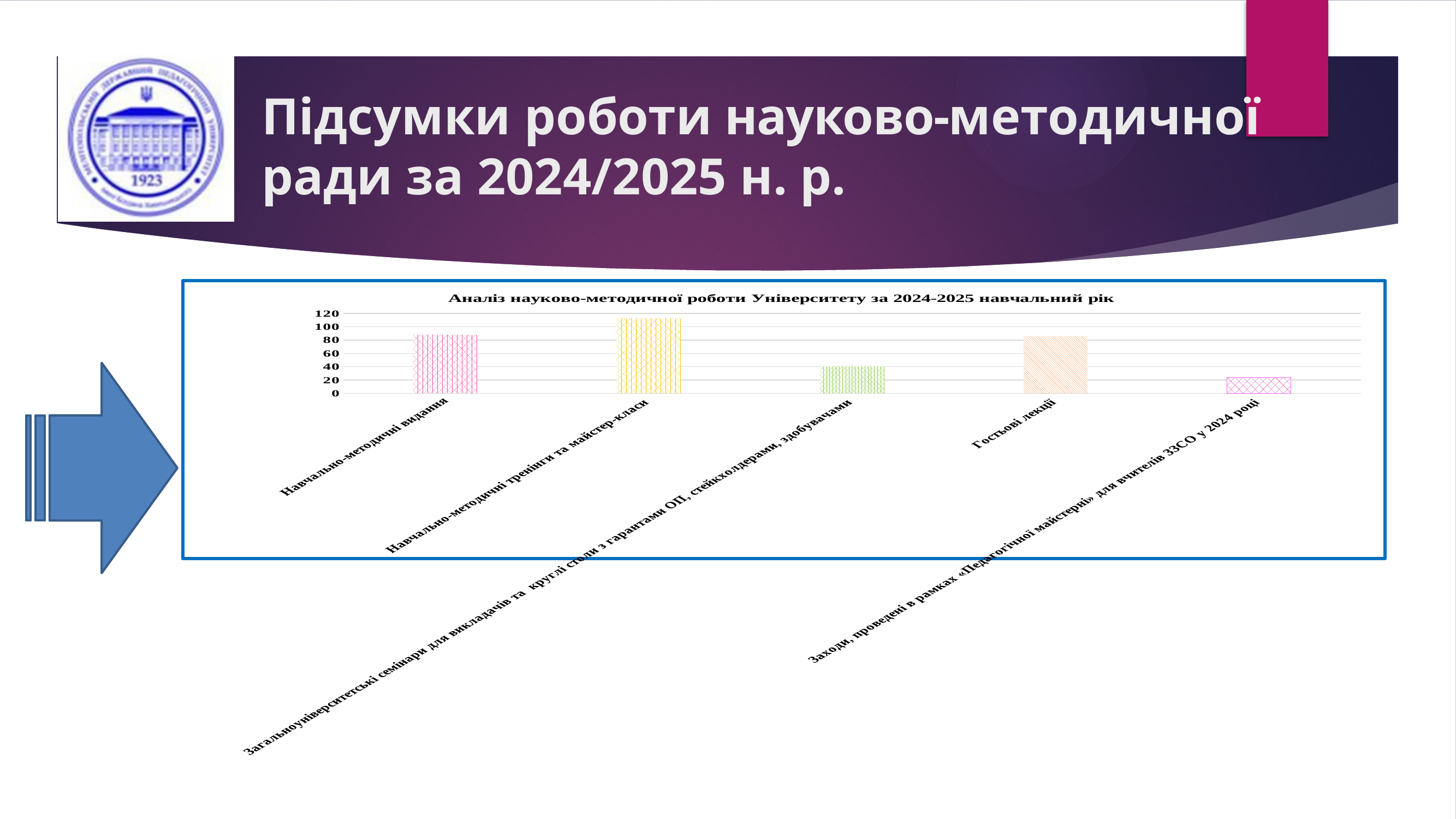
Is the value for Навчально-методичні тренінги та майстер-класи greater or less than 100? greater Which category has the highest bar in the chart? Навчально-методичні тренінги та майстер-класи Is the value for Навчально-методичні видання greater or less than 60? greater Is the value for Загальноуніверситетські семінари для викладачів та круглі столи з гарантами ОП, стейкхолдерами, здобувачами greater or less than 60? less Which category has the lowest bar in the chart? Заходи, проведені в рамках «Педагогічної майстерні» для вчителів ЗЗСО у 2024 році What kind of chart is shown on the slide? bar chart What is the title of the chart? Аналіз науково-методичної роботи Університету за 2024-2025 навчальний рік Which is larger: the value for Навчально-методичні тренінги та майстер-класи or the value for Гостьові лекції? Навчально-методичні тренінги та майстер-класи Which is larger: the value for Загальноуніверситетські семінари для викладачів та круглі столи з гарантами ОП, стейкхолдерами, здобувачами or the value for Заходи, проведені в рамках «Педагогічної майстерні» для вчителів ЗЗСО у 2024 році? Загальноуніверситетські семінари для викладачів та круглі столи з гарантами ОП, стейкхолдерами, здобувачами How many categories are plotted in the chart? 5